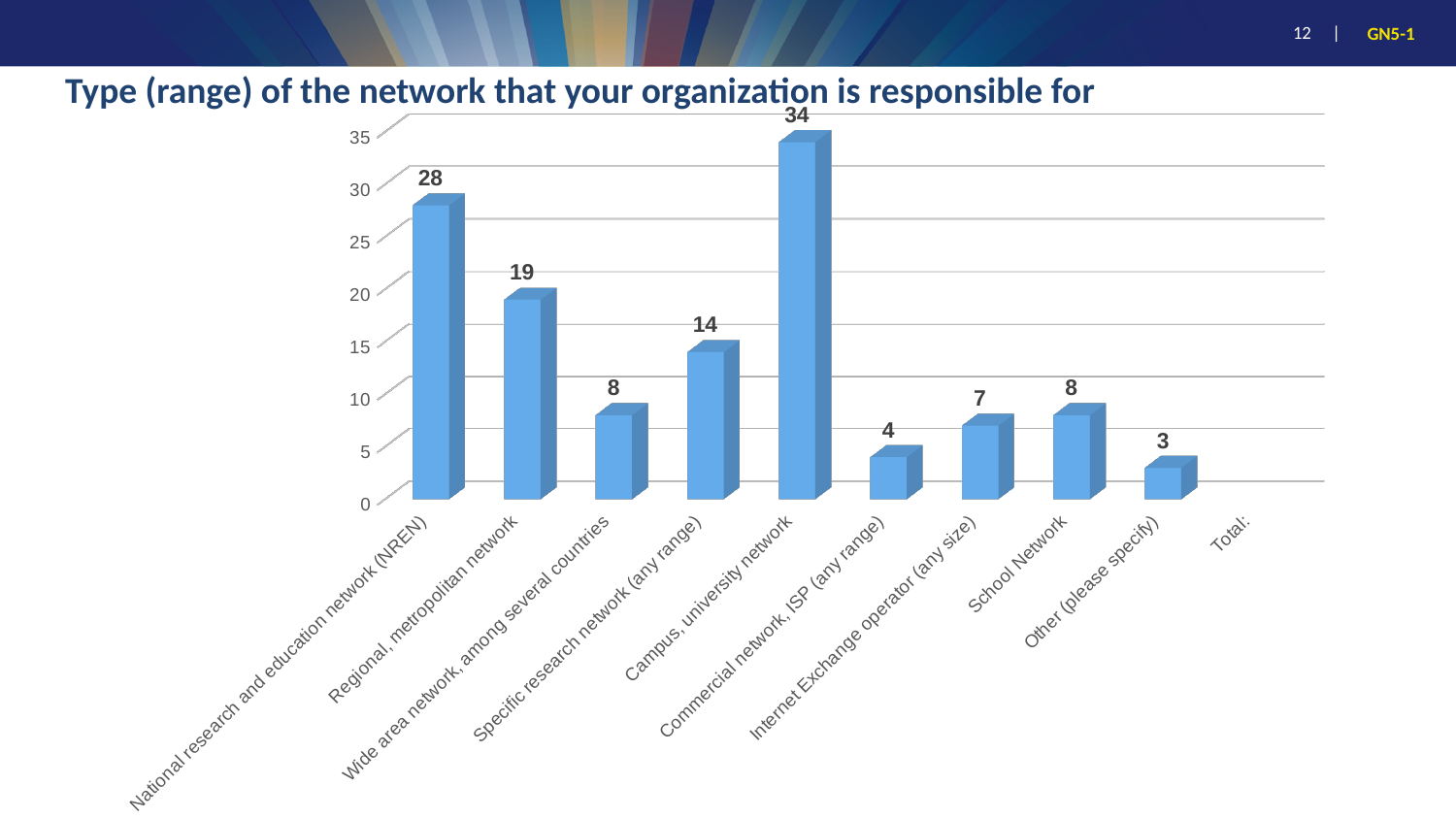
What is the difference between the values for Regional, metropolitan network and Specific research network (any range)? 5 What is the value for Internet Exchange operator (any size)? 7 What is the value for Campus, university network? 34 Which category has the highest value? Campus, university network What is the value for National research and education network (NREN)? 28 What kind of chart is shown on the slide? Bar chart Which category has the lowest value? Other (please specify) How many bars are plotted in the chart? 9 What is the title of the chart? Type (range) of the network that your organization is responsible for What is the value for Other (please specify)? 3 What is the difference between the values for Campus, university network and National research and education network (NREN)? 6 Which is larger, the value for Regional, metropolitan network or the value for Specific research network (any range)? Regional, metropolitan network